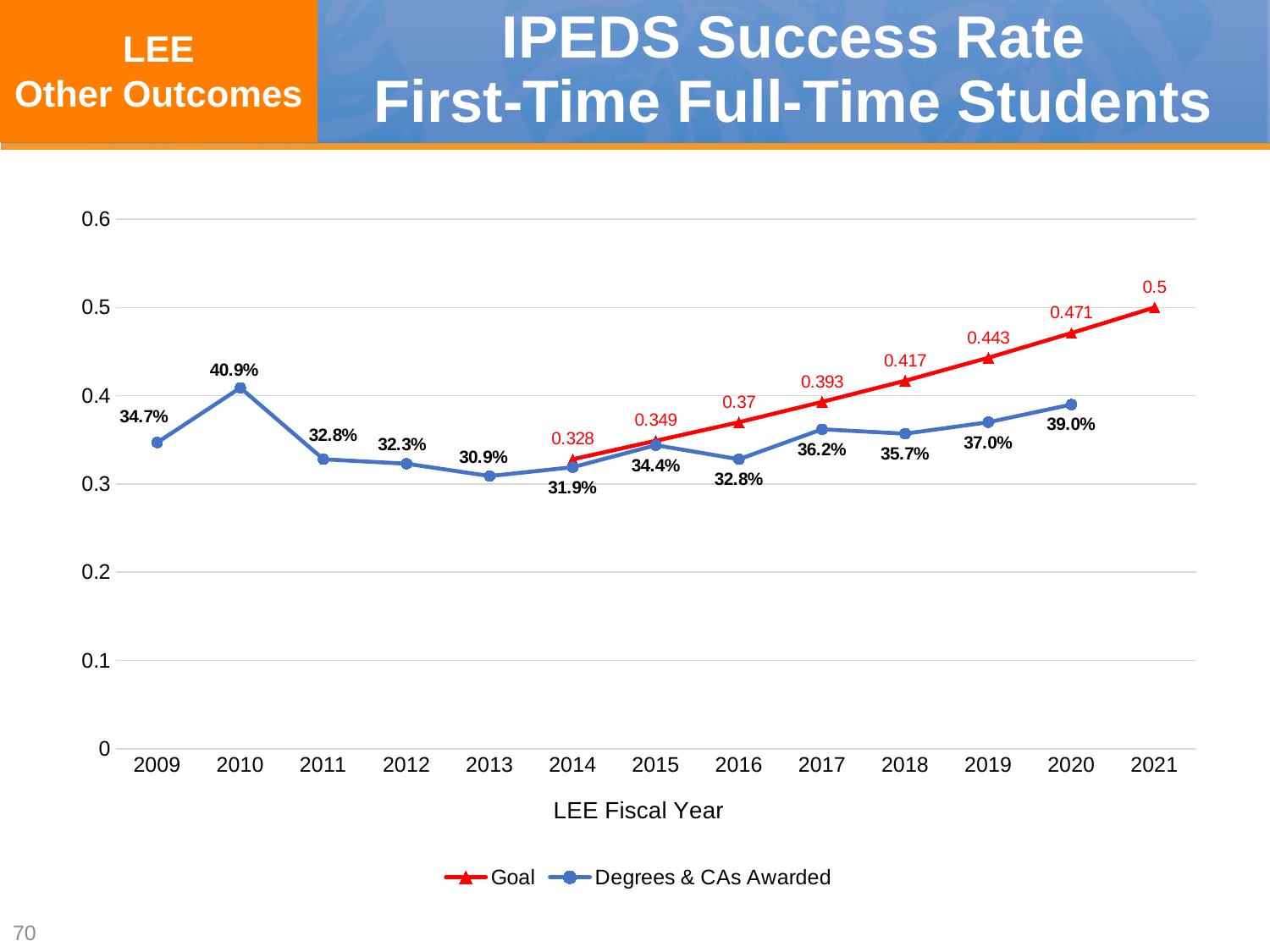
Which is larger in 2019, the Goal or the Degrees & CAs Awarded value? Goal Which year has the lowest Degrees & CAs Awarded value? 2013 How many series does the legend list? 2 What is the Goal value for 2018? 0.417 What is the Goal value for 2021? 0.5 How many years are shown on the x axis? 13 What is the Degrees & CAs Awarded value for 2010? 40.9% What kind of chart is this? Line chart Which year has the highest Degrees & CAs Awarded value? 2010 Does the Goal series rise or fall from 2014 to 2021? Rise What is the difference between the Degrees & CAs Awarded values for 2010 and 2009? 6.2% What is the Degrees & CAs Awarded value for 2020? 39.0%